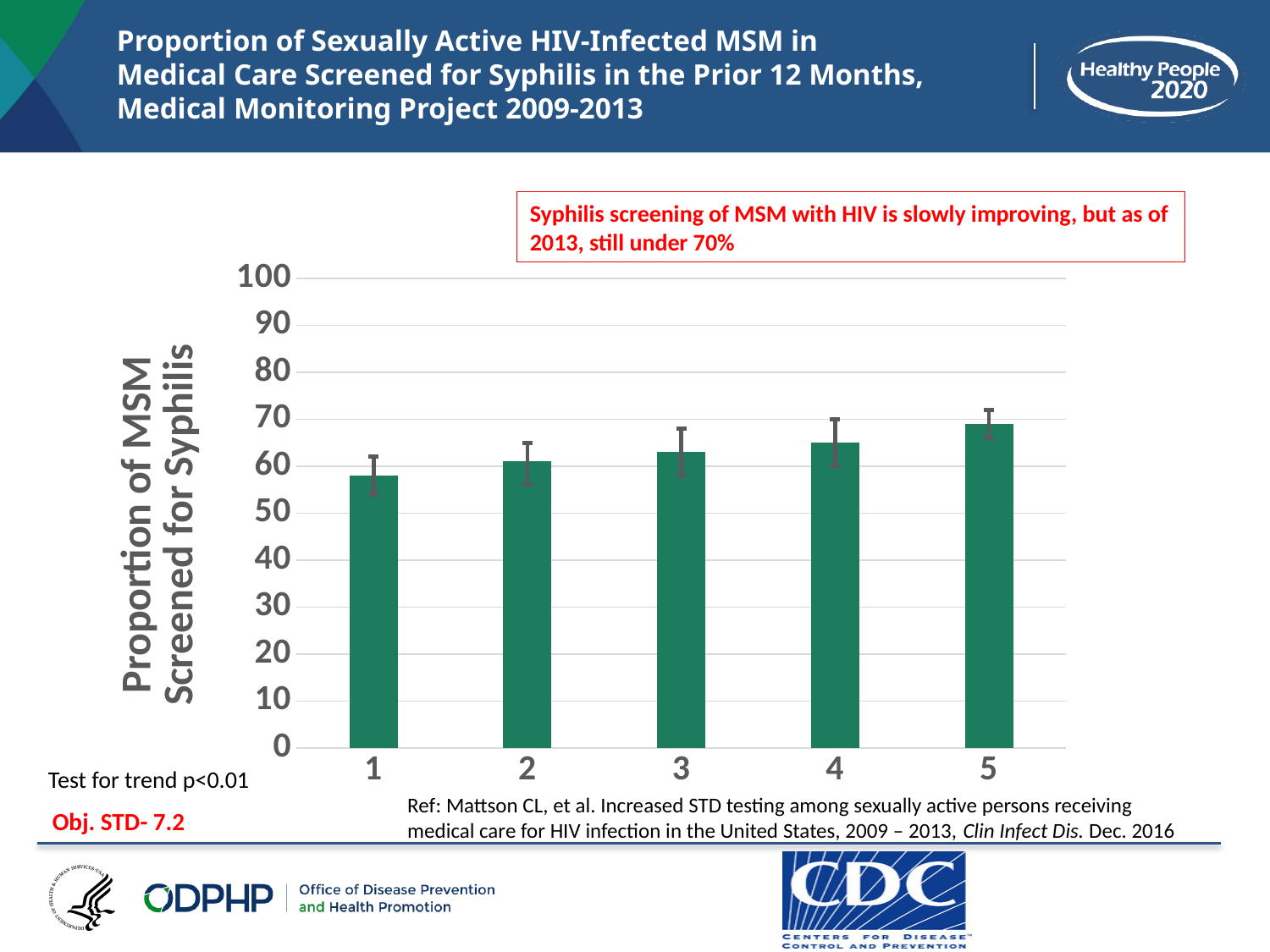
Which category has the lowest bar? 1 Which is larger, the value for category 5 or the value for category 1? Category 5 Which is larger, the value for category 4 or the value for category 2? Category 4 Is the value for category 5 greater or less than 60? greater Which category has the highest bar? 5 What kind of chart is shown on the slide? Bar chart What is the label on the vertical axis of the chart? Proportion of MSM Screened for Syphilis Is the value for category 1 greater or less than 50? greater Is the value for category 2 greater or less than 70? less How many bars (categories) are plotted on the chart? 5 What p-value is reported for the test for trend on the slide? p<0.01 Do the bar values rise or fall from category 1 to category 5? Rise